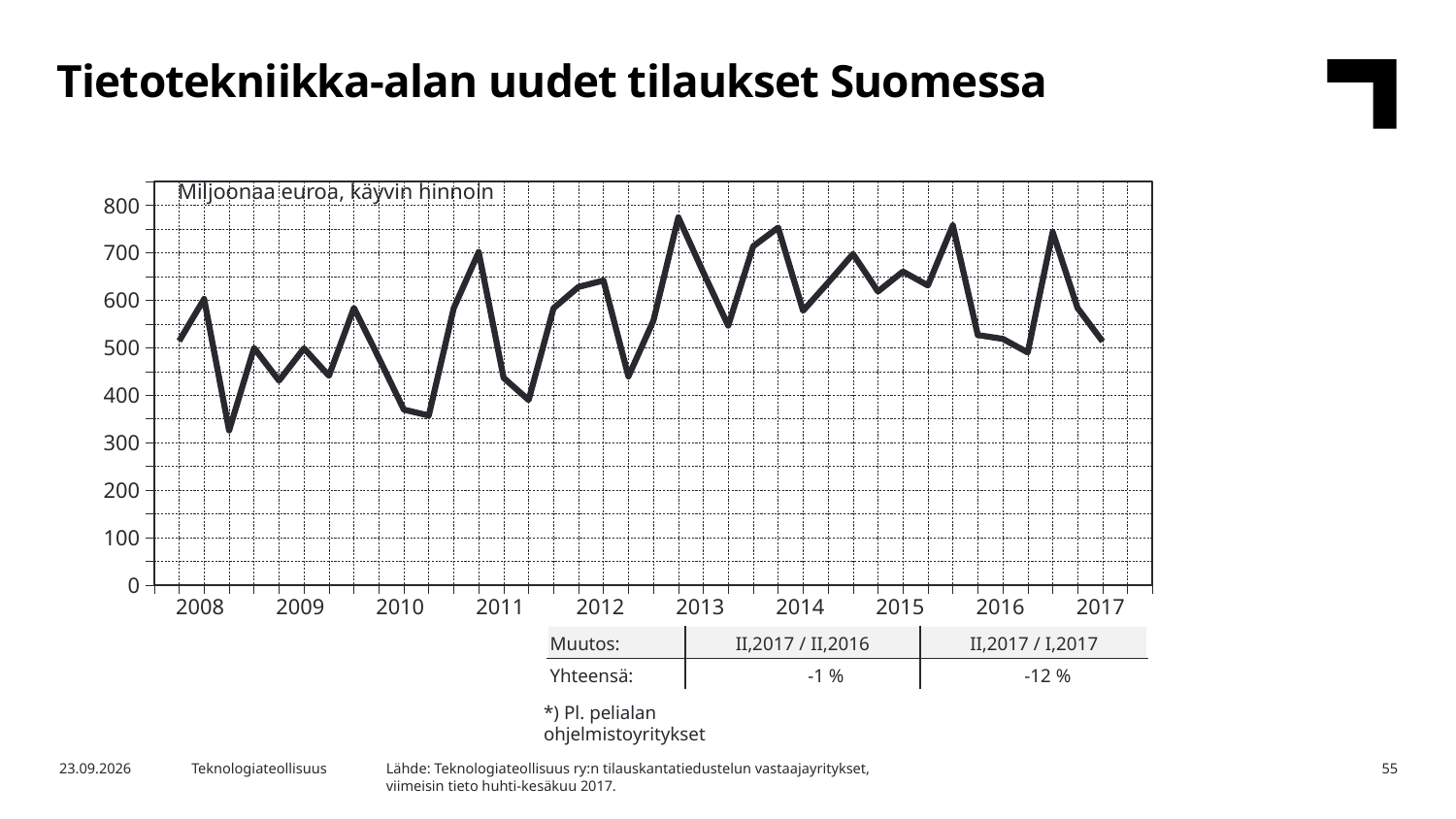
What kind of chart is shown on the slide? line chart According to the table below the chart, what is the change (Yhteensä) for II,2017 / I,2017? -12 % Is the highest point of the line in 2012 greater or less than 700? less Is the highest point of the line in 2016 greater or less than 700? greater Does the line rise or fall from its 2016 peak to the last point in 2017? fall Is the lowest point of the line in 2010 greater or less than 400? less According to the table below the chart, what is the change (Yhteensä) for II,2017 / II,2016? -1 % What is the title of the slide's chart? Tietotekniikka-alan uudet tilaukset Suomessa What unit is stated at the top of the chart's plot area? Miljoonaa euroa, käyvin hinnoin In which year does the line reach its lowest point? 2008